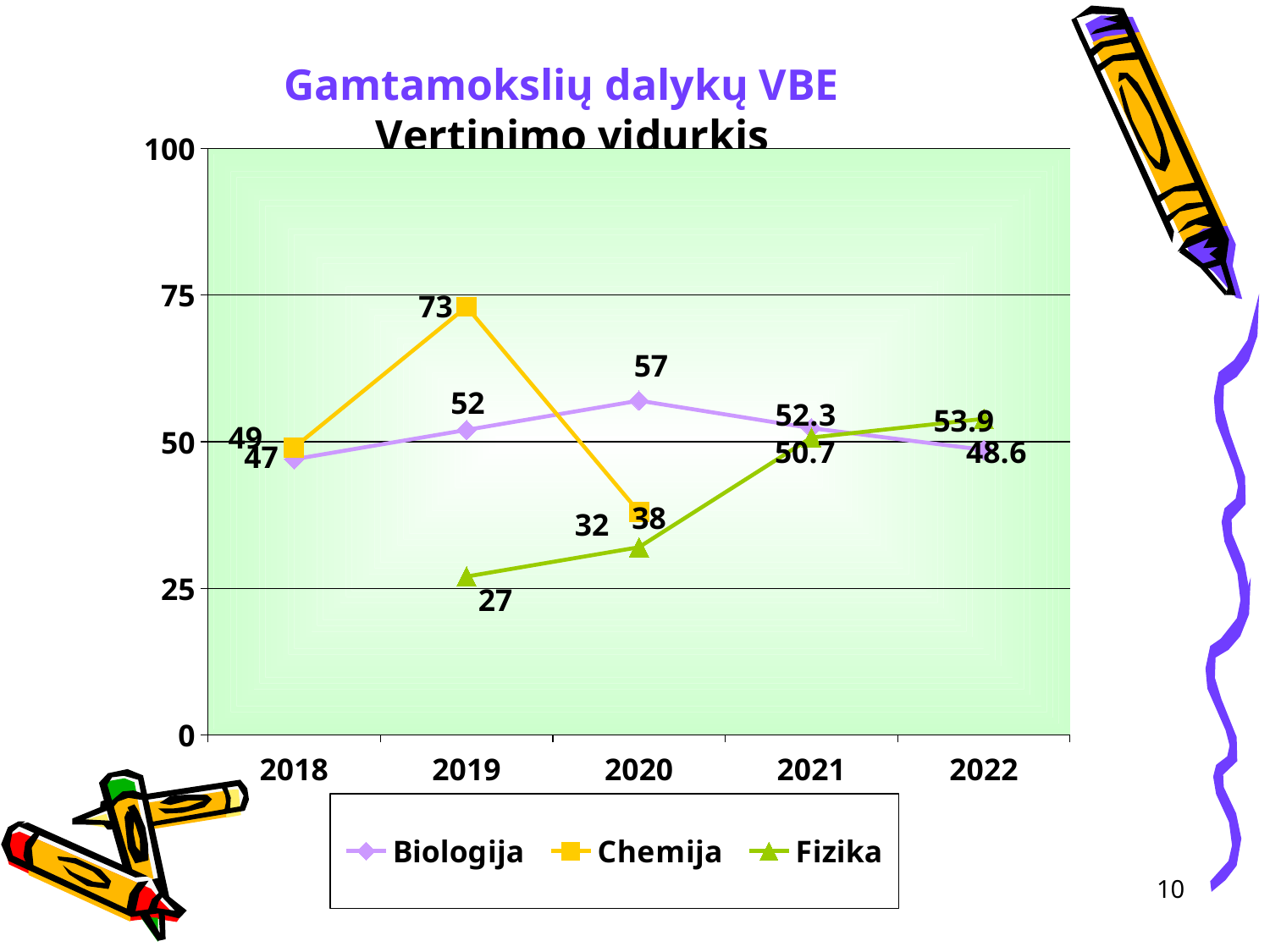
Does the Fizika line rise or fall from 2019 to 2022? rise What is the difference between the Chemija values in 2019 and 2020? 35 In 2021, which is larger: the Biologija value or the Fizika value? Biologija What is the value for Chemija in 2019? 73 In which year is the Biologija value highest? 2020 In which year is the Fizika value lowest? 2019 What is the value for Biologija in 2020? 57 What is the value for Biologija in 2022? 48.6 How many series does the legend list? 3 What is the value for Fizika in 2019? 27 How many years are shown on the x axis? 5 What kind of chart is shown on the slide? line chart